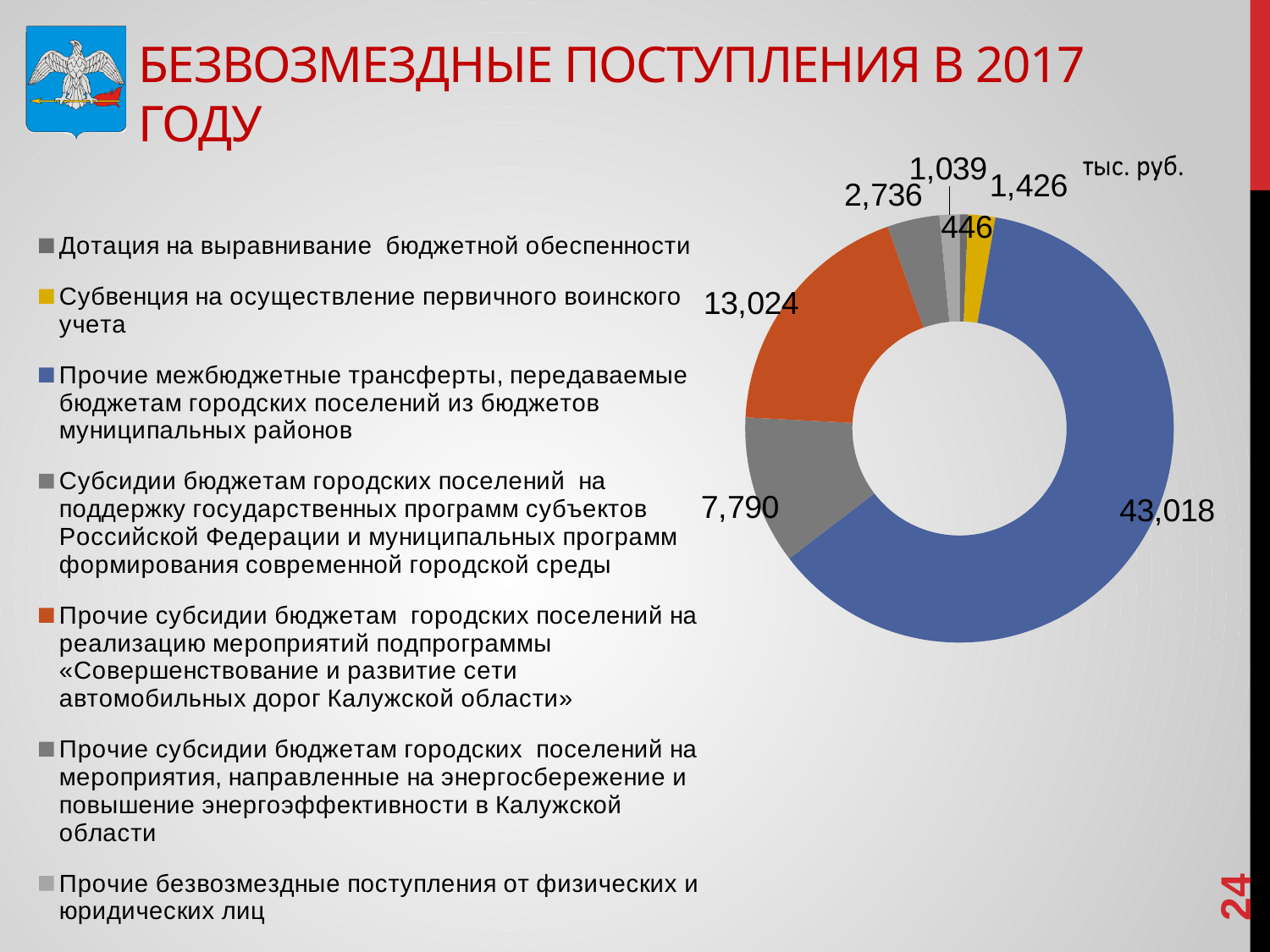
What is the total of all values shown on the chart? 69,479 What colour is the largest slice of the chart? Blue Which category has the largest value in the chart? Прочие межбюджетные трансферты, передаваемые бюджетам городских поселений из бюджетов муниципальных районов What is the value for «Прочие субсидии бюджетам городских поселений на реализацию мероприятий подпрограммы «Совершенствование и развитие сети автомобильных дорог Калужской области»»? 13,024 What is the value for «Прочие межбюджетные трансферты, передаваемые бюджетам городских поселений из бюджетов муниципальных районов»? 43,018 What type of chart is shown on the slide? Pie (doughnut) chart Which is larger: the value 13,024 for the road-network subsidies or the value 7,790 for the urban-environment subsidies? 13,024 What is the difference between the largest value (43,018) and the value 13,024? 29,994 How many categories does the chart's legend list? 7 In what units are the chart values given? тыс. руб. What is the smallest value labelled on the chart? 446 What is the value for «Субсидии бюджетам городских поселений на поддержку государственных программ субъектов Российской Федерации и муниципальных программ формирования современной городской среды»? 7,790